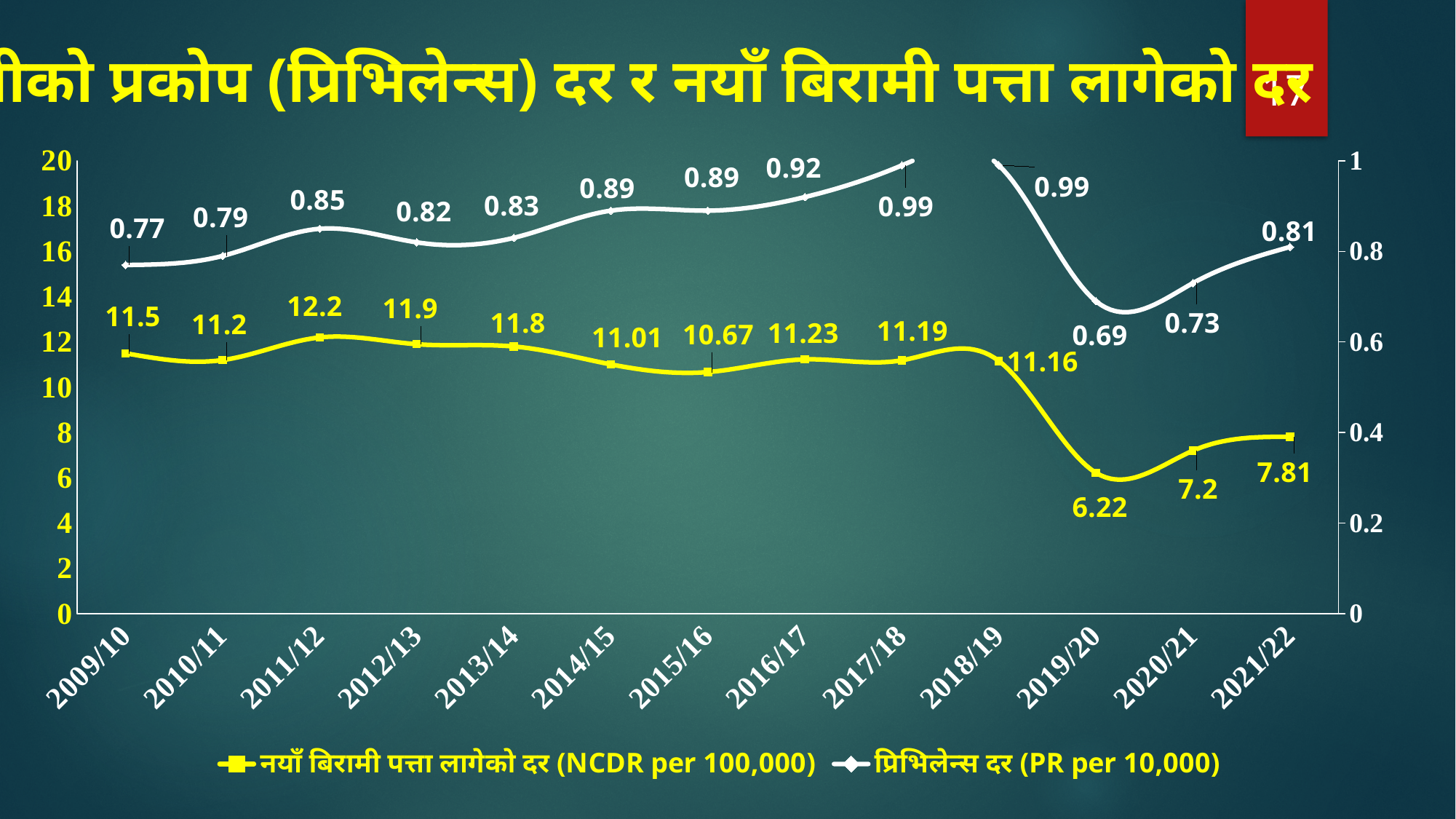
What is the difference between the NCDR per 100,000 values for 2018/19 and 2019/20? 4.94 What is the NCDR per 100,000 value for 2011/12? 12.2 What is the PR per 10,000 value for 2020/21? 0.73 What kind of chart is shown on the slide? line chart In which year is the NCDR per 100,000 value highest? 2011/12 How many series does the legend list? 2 In which year is the NCDR per 100,000 value lowest? 2019/20 What is the NCDR per 100,000 value for 2019/20? 6.22 How many fiscal years are plotted along the x axis? 13 Does the NCDR per 100,000 series rise or fall from 2019/20 to 2021/22? rise In which year is the PR per 10,000 value lowest? 2019/20 Which is larger, the PR per 10,000 value for 2021/22 or for 2020/21? 2021/22